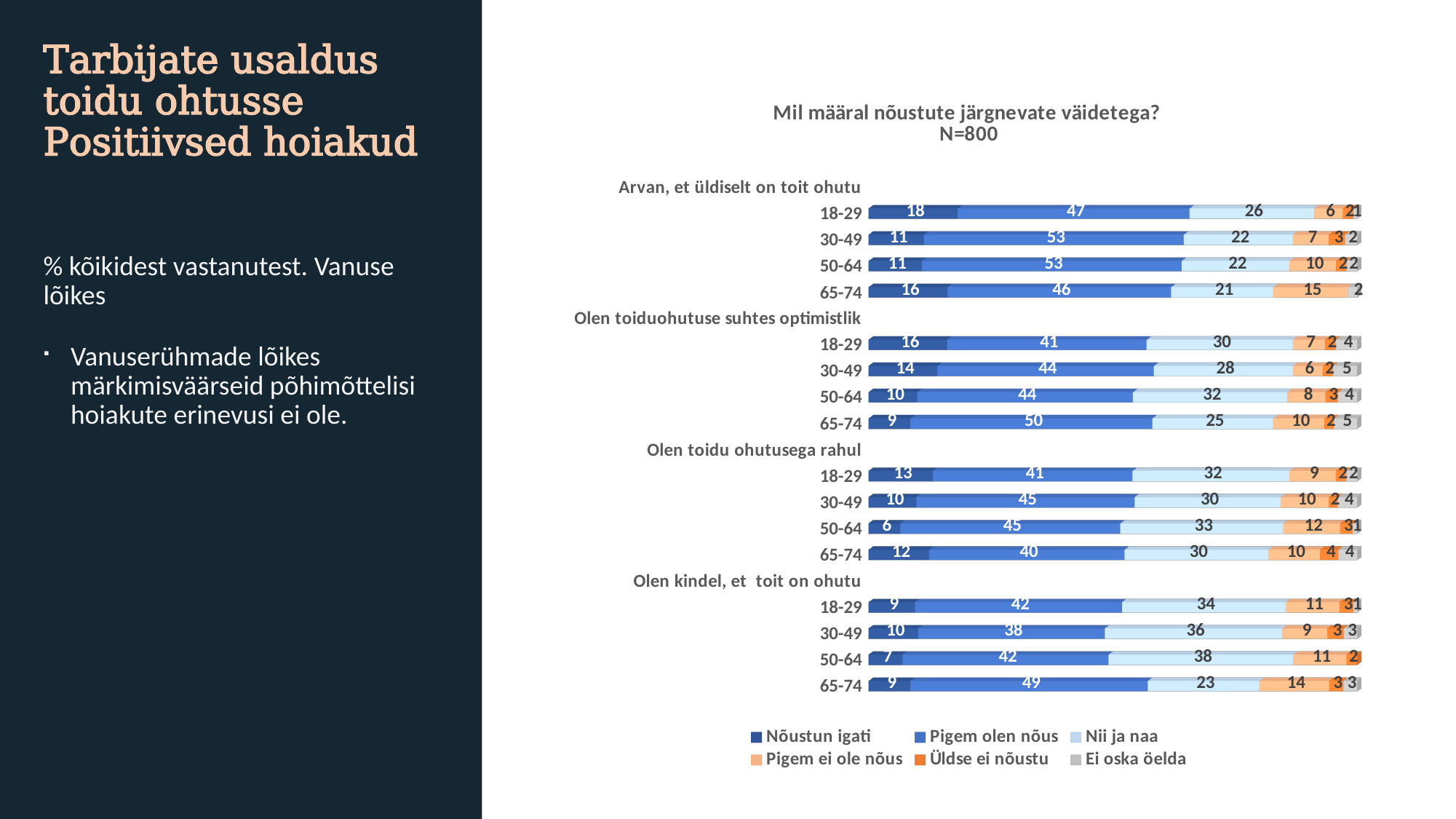
Under 'Olen toiduohutuse suhtes optimistlik', is the 'Nii ja naa' value larger for 50-64 or for 65-74? 50-64 What type of chart is shown on the slide? Stacked bar chart What is the 'Pigem olen nõus' value for the 30-49 age group under 'Arvan, et üldiselt on toit ohutu'? 53 What is the 'Pigem ei ole nõus' value for the 65-74 age group under 'Arvan, et üldiselt on toit ohutu'? 15 Under 'Olen kindel, et toit on ohutu', what is the difference between the 'Pigem olen nõus' values for 65-74 and 30-49? 11 What is the 'Nõustun igati' value for the 18-29 age group under 'Arvan, et üldiselt on toit ohutu'? 18 What is the 'Nii ja naa' value for the 50-64 age group under 'Olen kindel, et toit on ohutu'? 38 How many series does the legend list? 6 Under 'Olen toidu ohutusega rahul', which age group has the lowest 'Nõustun igati' value? 50-64 How many age groups are shown for each statement? 4 What sample size (N) is stated in the chart title? N=800 Under 'Olen toiduohutuse suhtes optimistlik', which age group has the highest 'Pigem olen nõus' value? 65-74